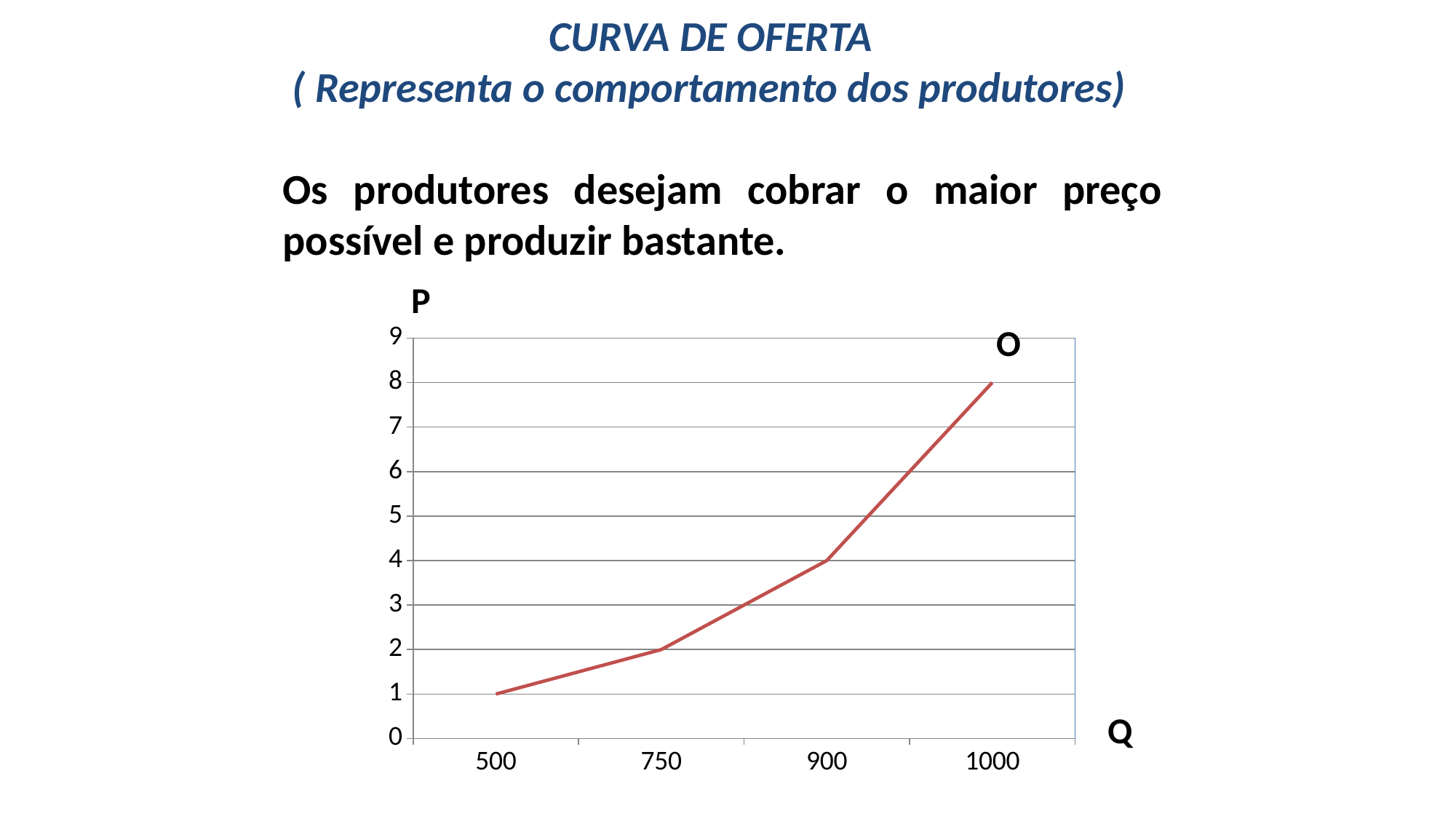
At which Q value is P lowest? 500 What kind of chart is shown on the slide? line chart Do the values of P rise or fall as Q increases along the x axis? rise What is the value of P at Q = 900? 4 At which Q value is P highest? 1000 What is the value of P at Q = 1000? 8 What is the value of P at Q = 500? 1 What letter labels the curve at its upper right end? O How many Q values are plotted on the x axis? 4 What is the value of P at Q = 750? 2 Which is larger, P at Q = 750 or P at Q = 900? Q = 900 What is the difference between P at Q = 1000 and P at Q = 900? 4